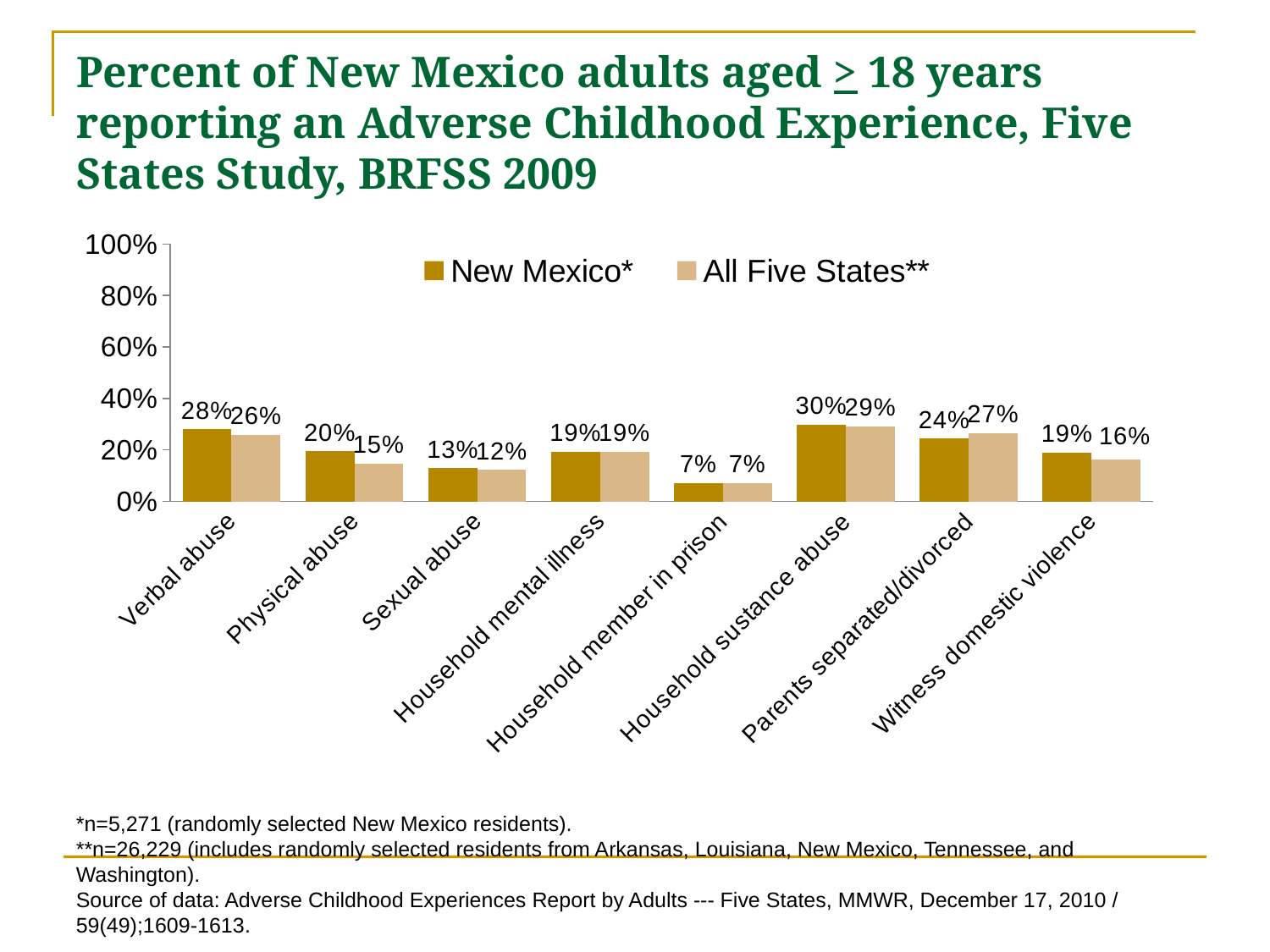
What are the two series named in the legend? New Mexico* and All Five States** What percent of New Mexico adults reported verbal abuse? 28% What is the difference between the New Mexico and All Five States values for witness domestic violence? 3% How many adverse childhood experience categories are shown on the x axis? 8 Which adverse childhood experience has the lowest All Five States value? Household member in prison For parents separated/divorced, which is larger: the New Mexico value or the All Five States value? All Five States How many series does the legend list? 2 What percent of New Mexico adults reported a household member in prison? 7% What kind of chart is shown on the slide? Bar chart What is the All Five States value for parents separated/divorced? 27% Which adverse childhood experience has the highest New Mexico value? Household sustance abuse What is the difference between the New Mexico and All Five States values for physical abuse? 5%